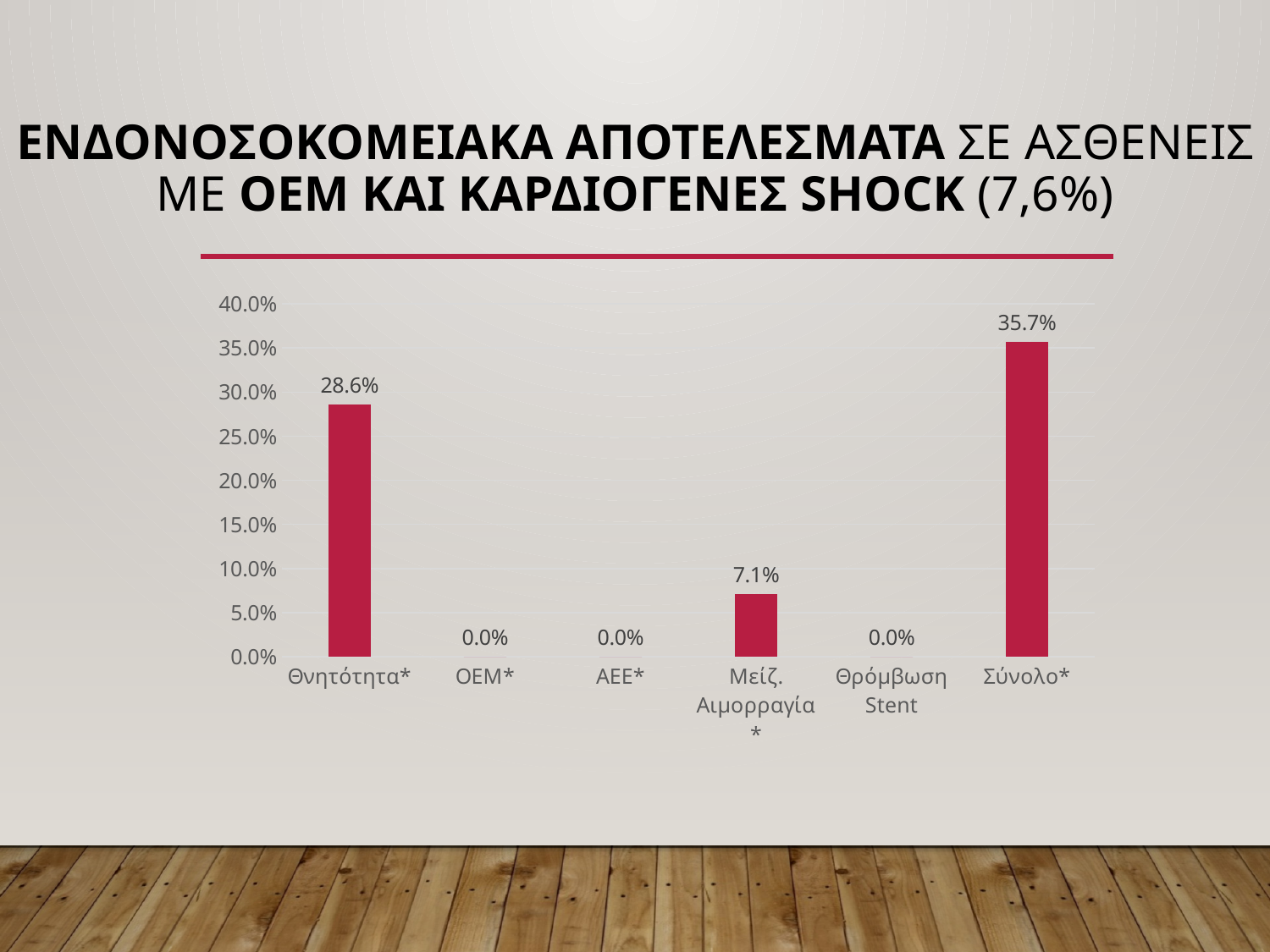
What is the value for Θρόμβωση Stent? 0.0% What is the value for Μείζ. Αιμορραγία*? 7.1% Which category has the highest value? Σύνολο* What is the value for Σύνολο*? 35.7% What is the difference between the values for Σύνολο* and Θνητότητα*? 7.1% Which is larger, the value for Θνητότητα* or the value for Μείζ. Αιμορραγία*? Θνητότητα* How many categories are shown on the x axis? 6 What is the value for Θνητότητα*? 28.6% What is the highest value shown on the y axis? 40.0% What kind of chart is shown on the slide? Bar chart Is the value for Σύνολο* greater or less than 30.0%? greater How many categories have a value of 0.0%? 3